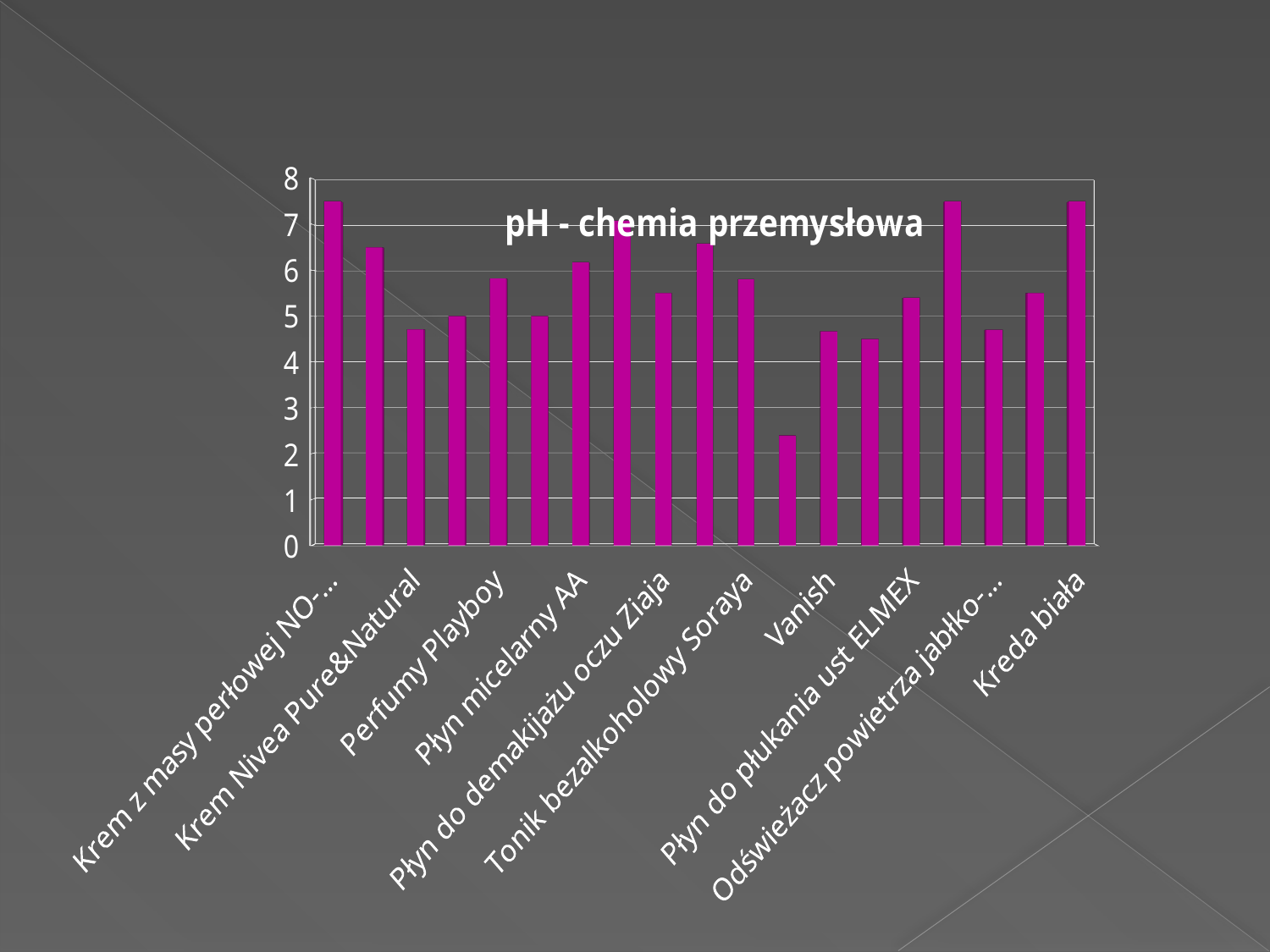
Is the value for Vanish greater or less than 5? less What is the title of the chart? pH - chemia przemysłowa Is the value for Krem Nivea Pure&Natural greater or less than 5? less How many bars are plotted in the chart? 19 Which has the larger value, Kreda biała or Vanish? Kreda biała Is the value for Płyn micelarny AA greater or less than 5? greater Which has the larger value, Perfumy Playboy or Krem Nivea Pure&Natural? Perfumy Playboy What kind of chart is shown on the slide? bar chart